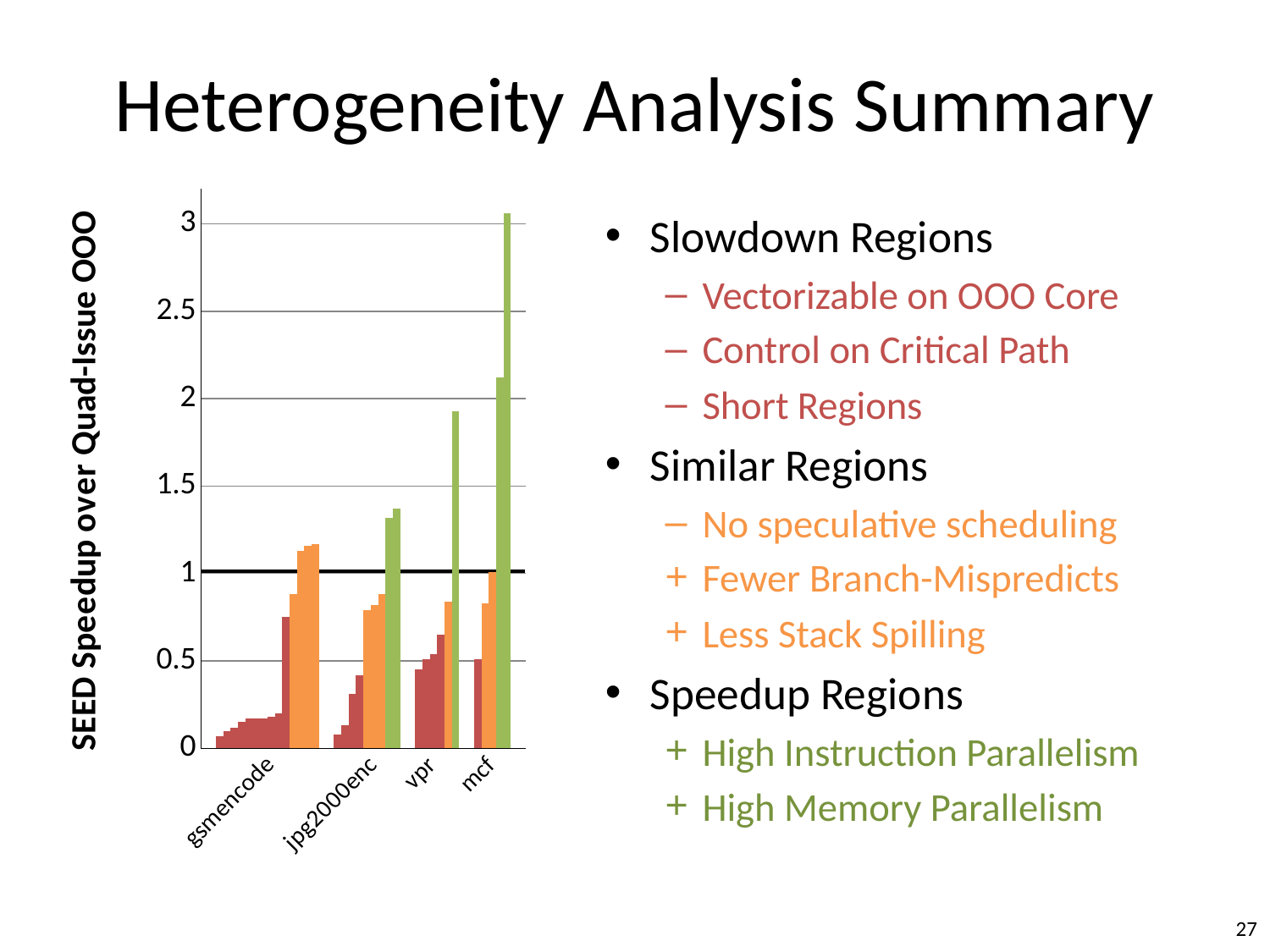
Is the tallest bar for jpg2000enc greater or less than 1.5? less Which benchmark category has no green bars? gsmencode Is the tallest bar for mcf greater or less than 2.5? greater How many benchmark categories are labelled on the x axis of the chart? 4 What kind of chart is shown on the slide? bar chart Is the tallest bar for vpr greater or less than 1.5? greater Which benchmark category contains the tallest bar in the chart? mcf What is the title of the y axis of the chart? SEED Speedup over Quad-Issue OOO Which has a taller maximum bar, vpr or jpg2000enc? vpr What is the highest tick value shown on the y axis of the chart? 3 At what y-axis value is the bold horizontal reference line drawn across the chart? 1